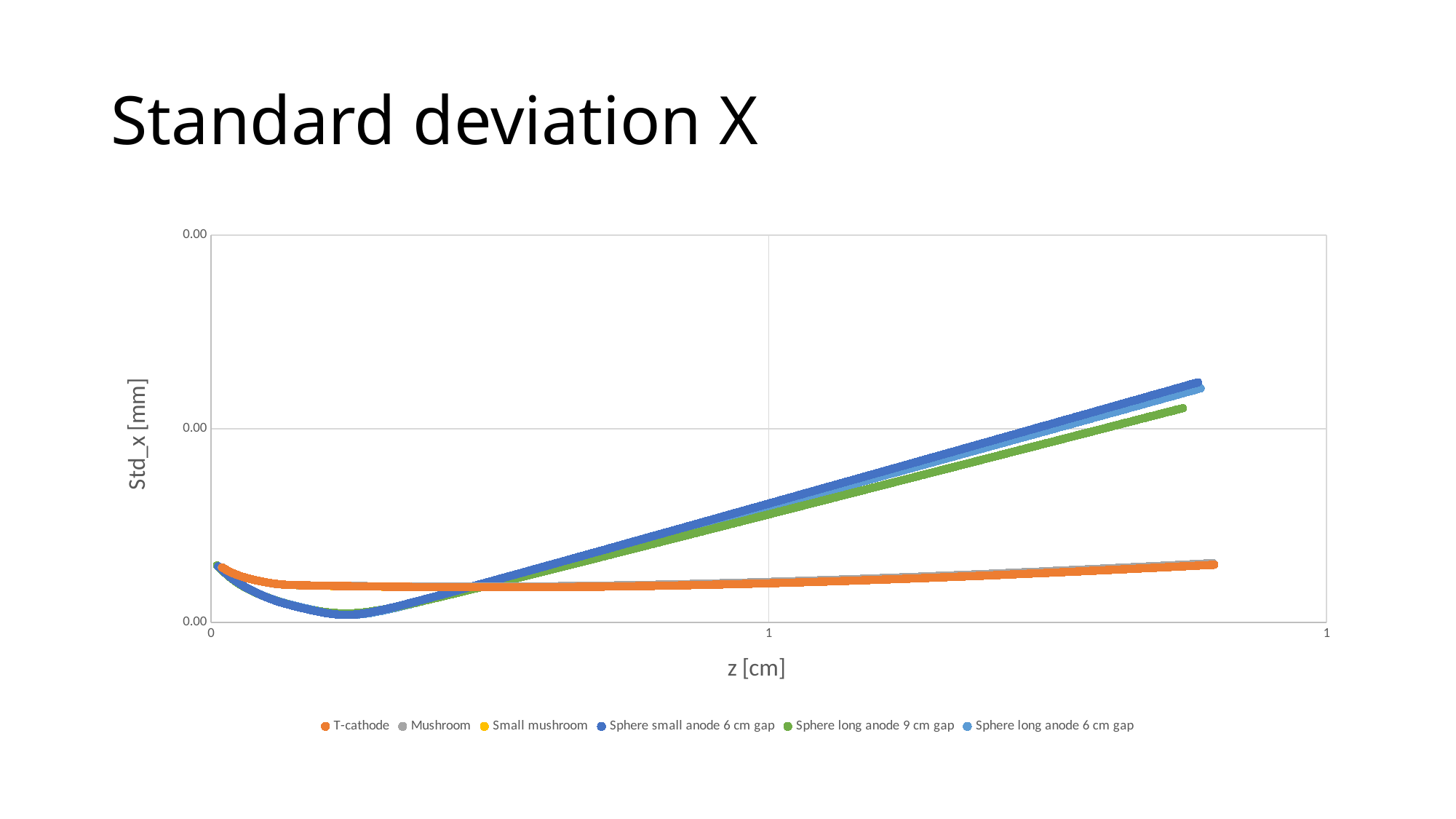
Does the T-cathode series rise or fall over the right half of the x axis? rises Over the right half of the x axis, does the Sphere small anode 6 cm gap series rise or fall? rises How many series does the legend list? 6 What is the title of the x axis? z [cm] At the right end of the chart, which is higher: Sphere small anode 6 cm gap or Sphere long anode 9 cm gap? Sphere small anode 6 cm gap What kind of chart is shown on the slide? line chart At the right end of the chart, which is higher: Sphere long anode 9 cm gap or T-cathode? Sphere long anode 9 cm gap Near the left of the chart where the sphere curves dip, which is lower: Sphere small anode 6 cm gap or T-cathode? Sphere small anode 6 cm gap What is the title of the y axis? Std_x [mm]